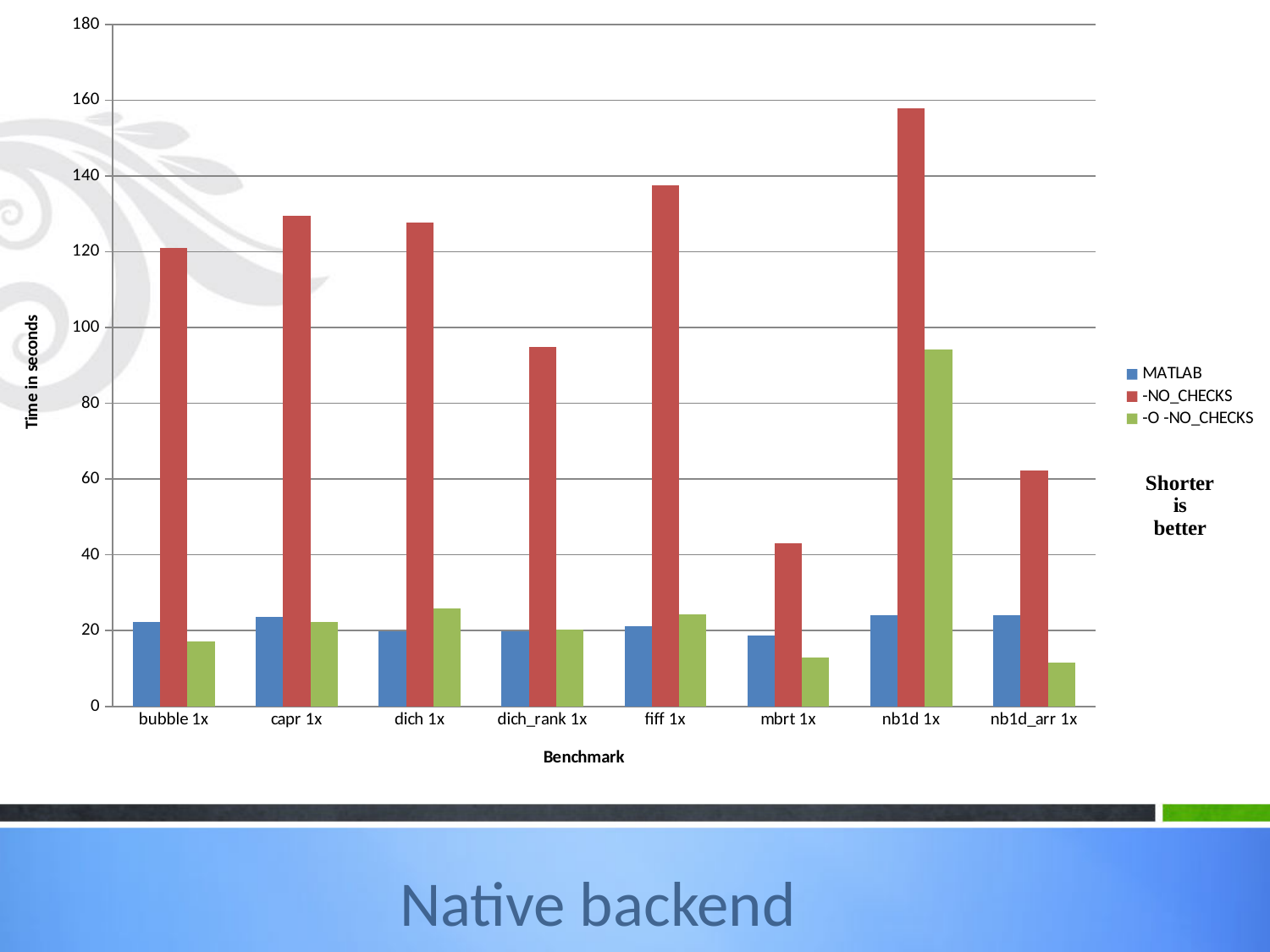
Which benchmark has the lowest -NO_CHECKS time? mbrt 1x How many benchmarks are shown on the x axis? 8 What kind of chart is shown on the slide? bar chart What is the title of the y axis? Time in seconds Is the -O -NO_CHECKS value for nb1d 1x greater or less than 80? greater How many series does the legend list? 3 Is the -NO_CHECKS value for nb1d_arr 1x greater or less than 80? less For nb1d 1x, which is larger: the -NO_CHECKS value or the -O -NO_CHECKS value? -NO_CHECKS Which benchmark has the highest -O -NO_CHECKS time? nb1d 1x Is the -NO_CHECKS value for bubble 1x greater or less than 100? greater Which benchmark has the highest -NO_CHECKS time? nb1d 1x